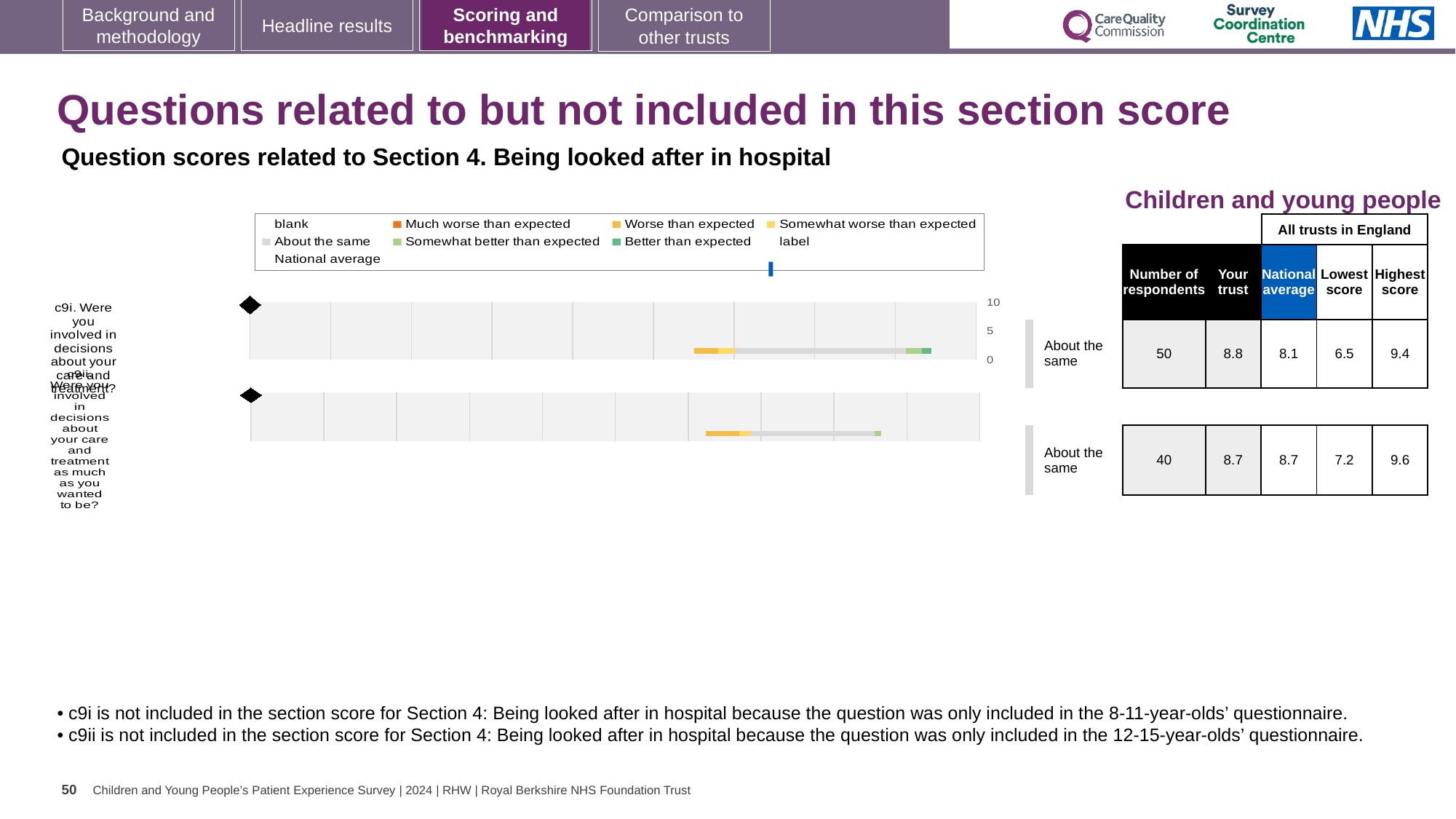
What is the highest value shown on the chart's axis? 10 In the table beside the chart, what is the lowest score across all trusts in England for c9i? 6.5 In the table beside the chart, what is the 'Your trust' score for c9i? 8.8 In the table beside the chart, what is the national average for c9ii? 8.7 What kind of chart is used to show the question scores for c9i and c9ii? bar chart In the table beside the chart, how many respondents answered c9i? 50 In the table beside the chart, which question has the higher 'Highest score' across all trusts in England, c9i or c9ii? c9ii What benchmark category is shown next to the c9ii bar? About the same In the table beside the chart, what is the difference between the 'Your trust' score and the national average for c9i? 0.7 How many entries does the chart legend list? 9 How many question rows (bars) are plotted in the chart area? 2 What benchmark category is shown next to the c9i bar? About the same